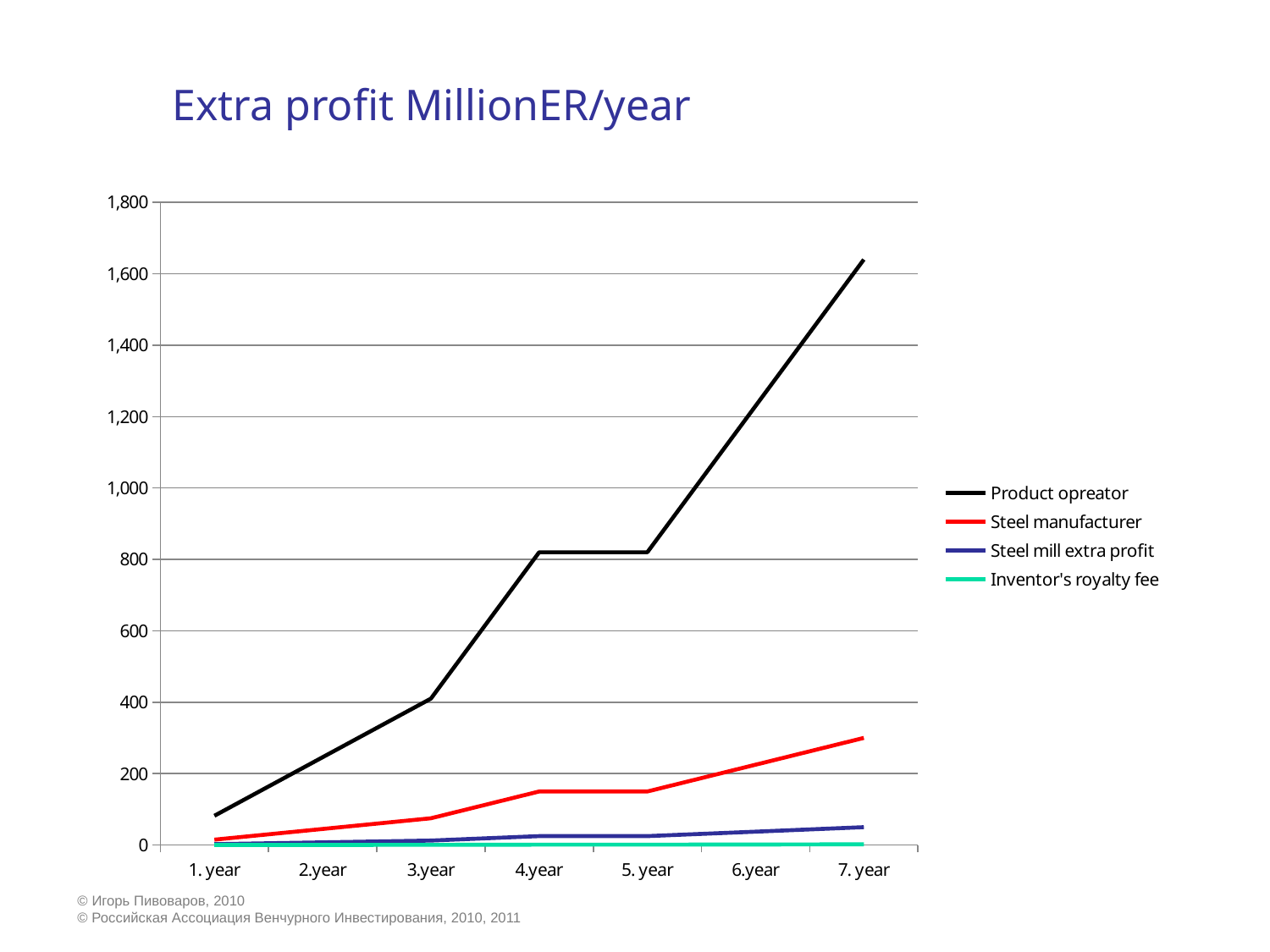
Does the Product opreator series rise or fall from 1. year to 7. year? rise In which year does the Product opreator series reach its highest value? 7. year How many series does the legend list? 4 What is the title of the chart? Extra profit MillionER/year Is the value for Product opreator at 7. year greater or less than 1,400? greater Is the value for Product opreator at 1. year greater or less than 200? less Which is larger at 5. year, Product opreator or Steel manufacturer? Product opreator What kind of chart is shown on the slide? line chart Is the value for Steel manufacturer at 7. year greater or less than 200? greater Which series has the lowest values across all years? Inventor's royalty fee Which series has the highest value at 7. year? Product opreator How many year categories are shown on the x axis? 7